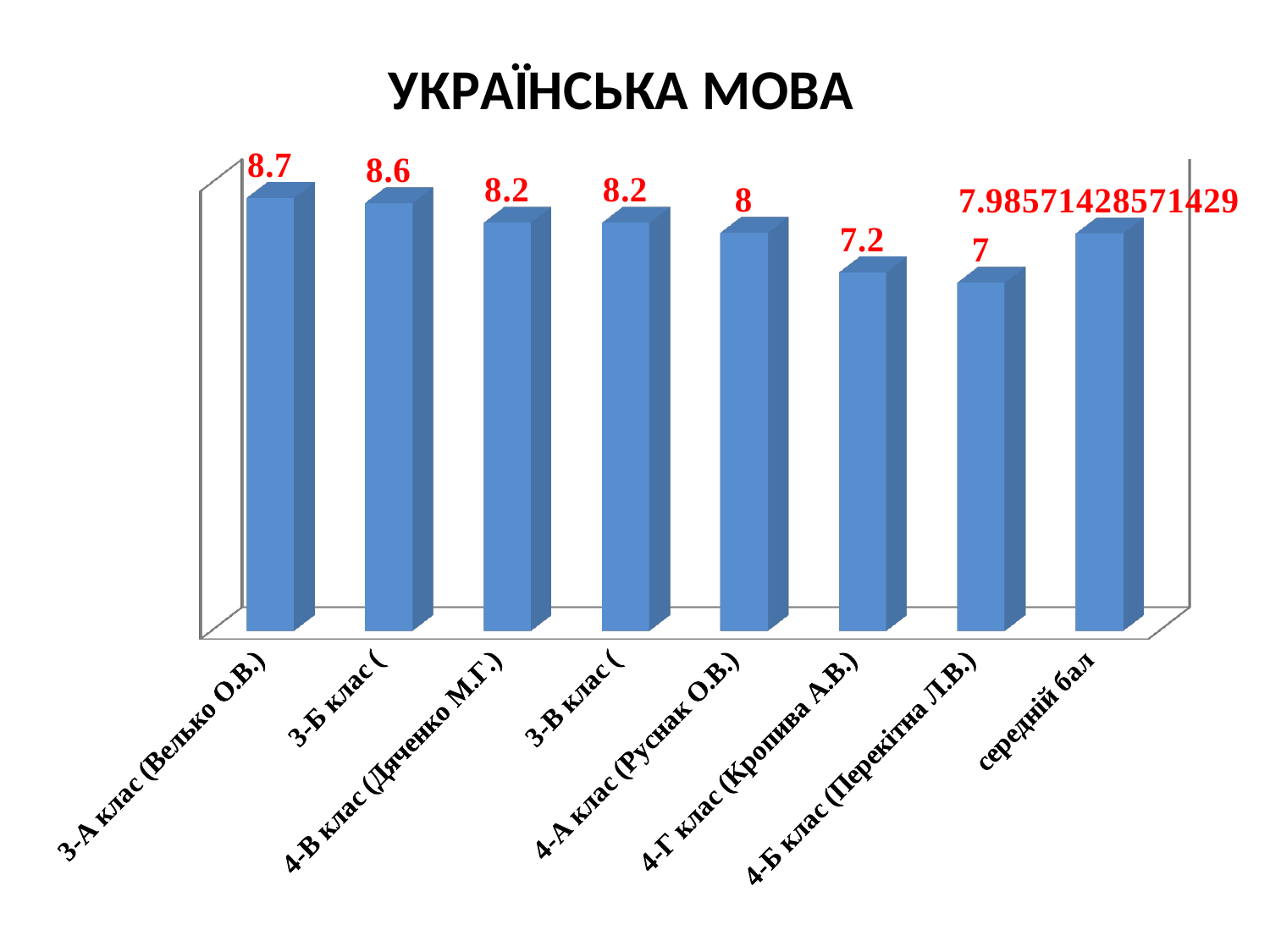
What is the value shown for середній бал? 7.98571428571429 What is the difference between the values for 3-А клас (Велько О.В.) and 4-Б клас (Перекітна Л.В.)? 1.7 What is the title of the chart? УКРАЇНСЬКА МОВА How many bars are shown in the chart? 8 Which category has the lowest value? 4-Б клас (Перекітна Л.В.) What is the value for 4-А клас (Руснак О.В.)? 8 What kind of chart is shown on the slide? bar chart What is the value for 3-А клас (Велько О.В.)? 8.7 Which is larger, the value for 4-В клас (Дяченко М.Г.) or the value for 4-А клас (Руснак О.В.)? 4-В клас (Дяченко М.Г.) What is the difference between the values for 3-Б клас and 4-Г клас (Кропива А.В.)? 1.4 What is the value for 4-Г клас (Кропива А.В.)? 7.2 Which category has the highest value? 3-А клас (Велько О.В.)